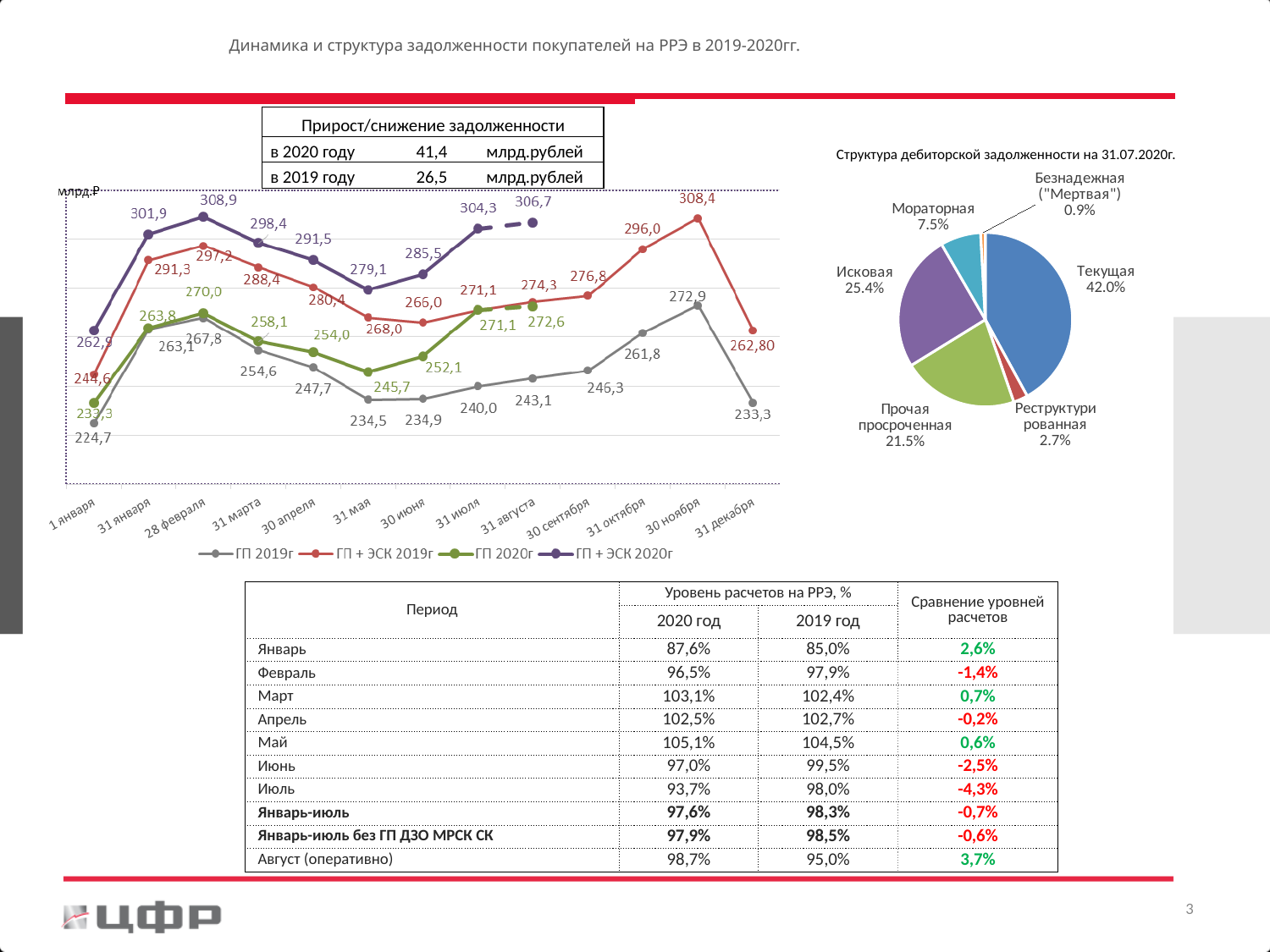
What kind of chart is the chart on the left of the slide? Line chart In the line chart on the left, what is the value of 'ГП + ЭСК 2020г' on 28 февраля? 308,9 In the line chart on the left, which is larger on 31 мая: 'ГП 2020г' or 'ГП 2019г'? ГП 2020г In the line chart on the left, what is the value of 'ГП + ЭСК 2019г' on 30 ноября? 308,4 How many slices does the pie chart 'Структура дебиторской задолженности на 31.07.2020г.' have? 6 In the line chart on the left, what is the value of 'ГП 2019г' on 31 декабря? 233,3 In the pie chart 'Структура дебиторской задолженности на 31.07.2020г.', which category has the smallest share? Безнадежная ("Мертвая") How many series does the legend of the line chart on the left list? 4 In the pie chart 'Структура дебиторской задолженности на 31.07.2020г.', which category has the largest share? Текущая In the pie chart 'Структура дебиторской задолженности на 31.07.2020г.', what share does 'Исковая' have? 25.4% In the line chart on the left, what is the difference between 'ГП + ЭСК 2020г' and 'ГП + ЭСК 2019г' on 28 февраля? 11,7 In the line chart on the left, does the 'ГП + ЭСК 2020г' series rise or fall from 28 февраля to 31 мая? Fall